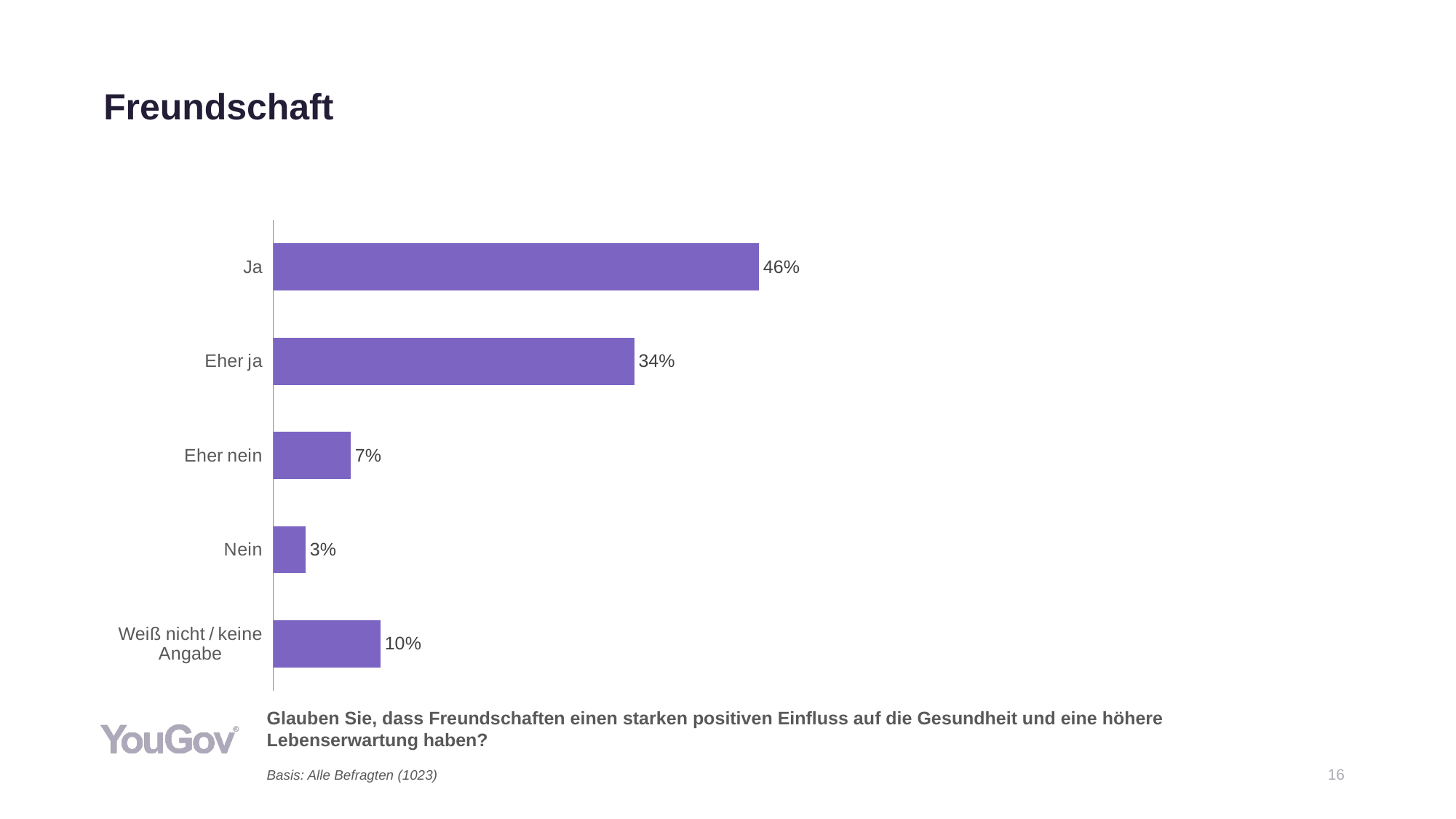
What percentage of respondents answered "Ja"? 46% What kind of chart is shown on the slide? Bar chart Which is larger, the value for "Eher nein" or the value for "Weiß nicht / keine Angabe"? Weiß nicht / keine Angabe What is the value for "Eher ja"? 34% How many categories are shown in the chart? 5 What is the title of the slide? Freundschaft Which category has the lowest value? Nein What is the difference between the values for "Ja" and "Eher ja"? 12% What is the combined value of "Ja" and "Eher ja"? 80% What is the value for "Weiß nicht / keine Angabe"? 10% Which category has the highest value? Ja What is the difference between the values for "Eher nein" and "Nein"? 4%